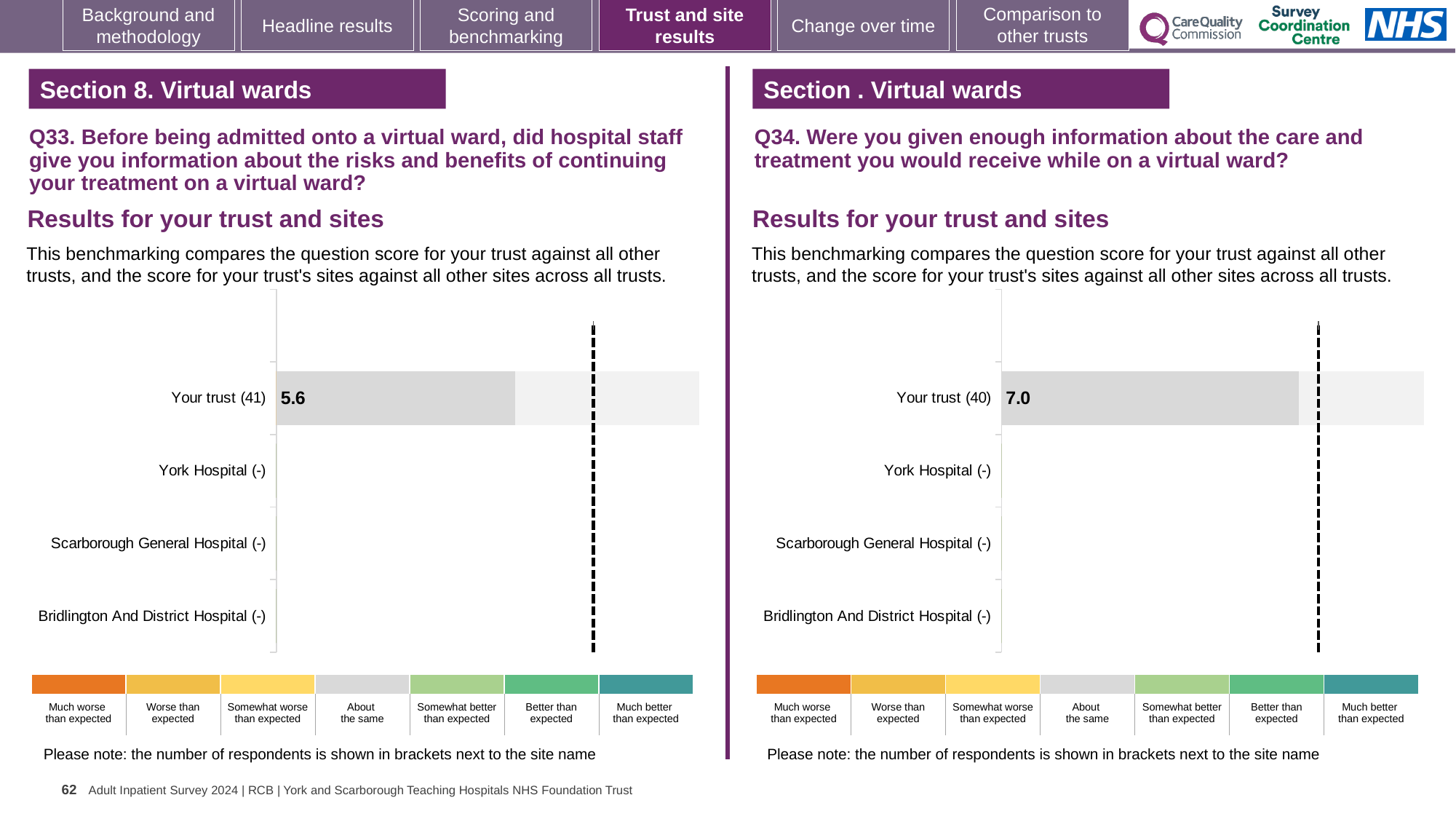
What kind of chart is used for the Q33 results on the left? Bar chart In the Q33 chart on the left, which category has a plotted bar? Your trust (41) In the Q33 chart on the left, what is the score for Your trust? 5.6 In the Q33 chart on the left, how many respondents are shown in brackets next to Your trust? 41 In the Q34 chart on the right, how many respondents are shown in brackets next to Your trust? 40 What is the difference between the Your trust score in the Q34 chart on the right and the Your trust score in the Q33 chart on the left? 1.4 How many categories (sites) are listed on the y axis of the Q33 chart on the left? 4 How many rating bands are shown in the colour key below the Q34 chart on the right? 7 How many categories (sites) are listed on the y axis of the Q34 chart on the right? 4 In the Q34 chart on the right, what is the score for Your trust? 7.0 Which is larger: the Your trust score in the Q33 chart on the left or the Your trust score in the Q34 chart on the right? Q34 chart (7.0)